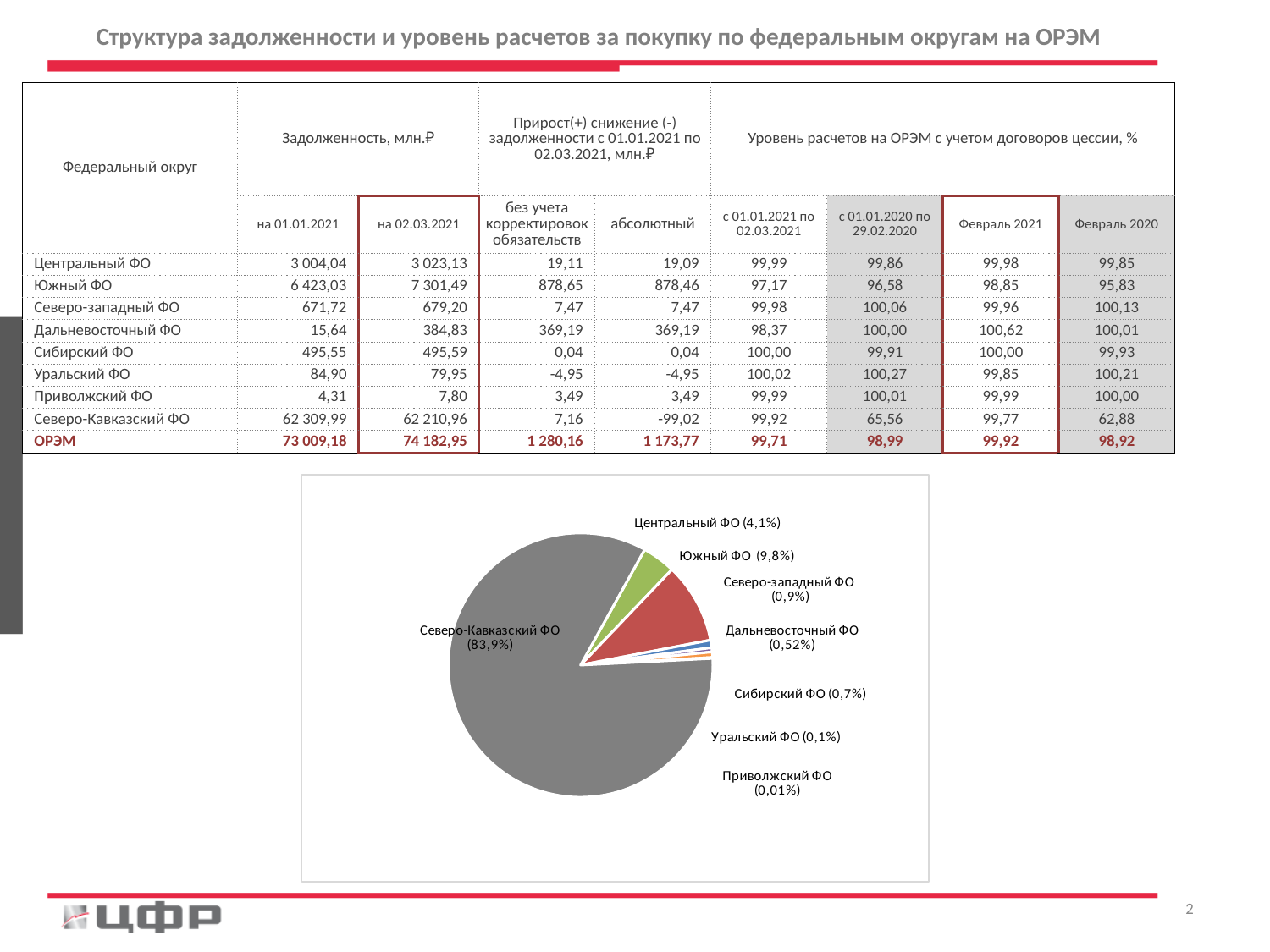
By how many percentage points does the share of Северо-Кавказский ФО exceed that of Южный ФО? 74,1 Which federal district has the largest share in the pie chart? Северо-Кавказский ФО What share of the pie does Дальневосточный ФО have? 0,52% What share of the pie does Уральский ФО have? 0,1% What share of the pie does Северо-Кавказский ФО have? 83,9% What kind of chart is shown on the slide? pie chart How many slices does the pie chart have? 8 Which has a larger share in the pie chart, Южный ФО or Центральный ФО? Южный ФО Which federal district has the smallest share in the pie chart? Приволжский ФО